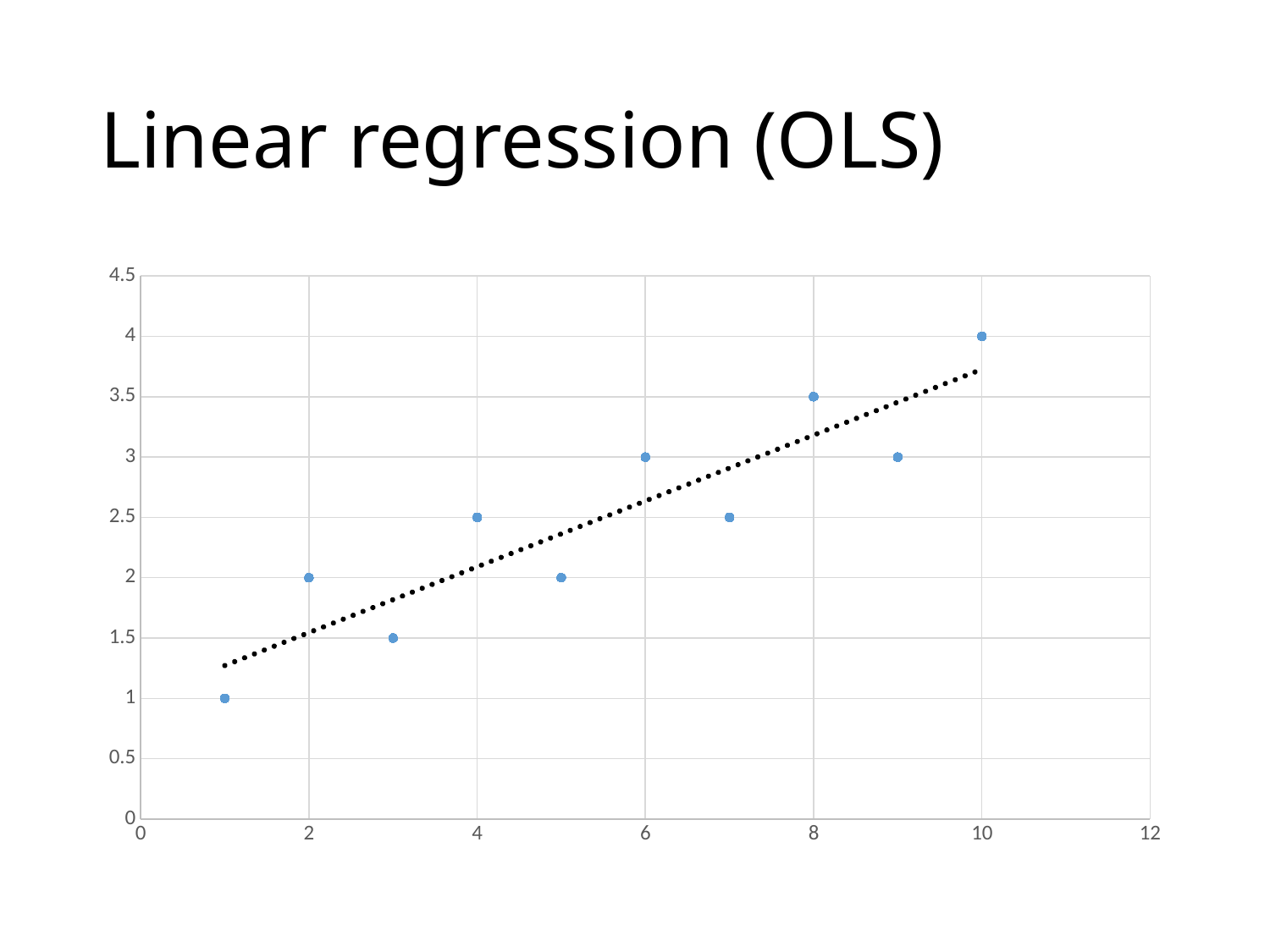
At which x value does the highest point occur? 10 Do the plotted values generally rise or fall as x increases? rise What kind of chart is shown on the slide? scatter plot What is the y value of the point at x = 10? 4 What is the title of the slide containing the chart? Linear regression (OLS) What is the y value of the point at x = 1? 1 Which has the larger y value, the point at x = 4 or the point at x = 5? x = 4 Is the y value of the point at x = 6 greater or less than 2.5? greater At which x value does the lowest point occur? 1 What is the y value of the point at x = 3? 1.5 What is the difference between the y values at x = 8 and x = 7? 1 How many data points are plotted on the chart? 10